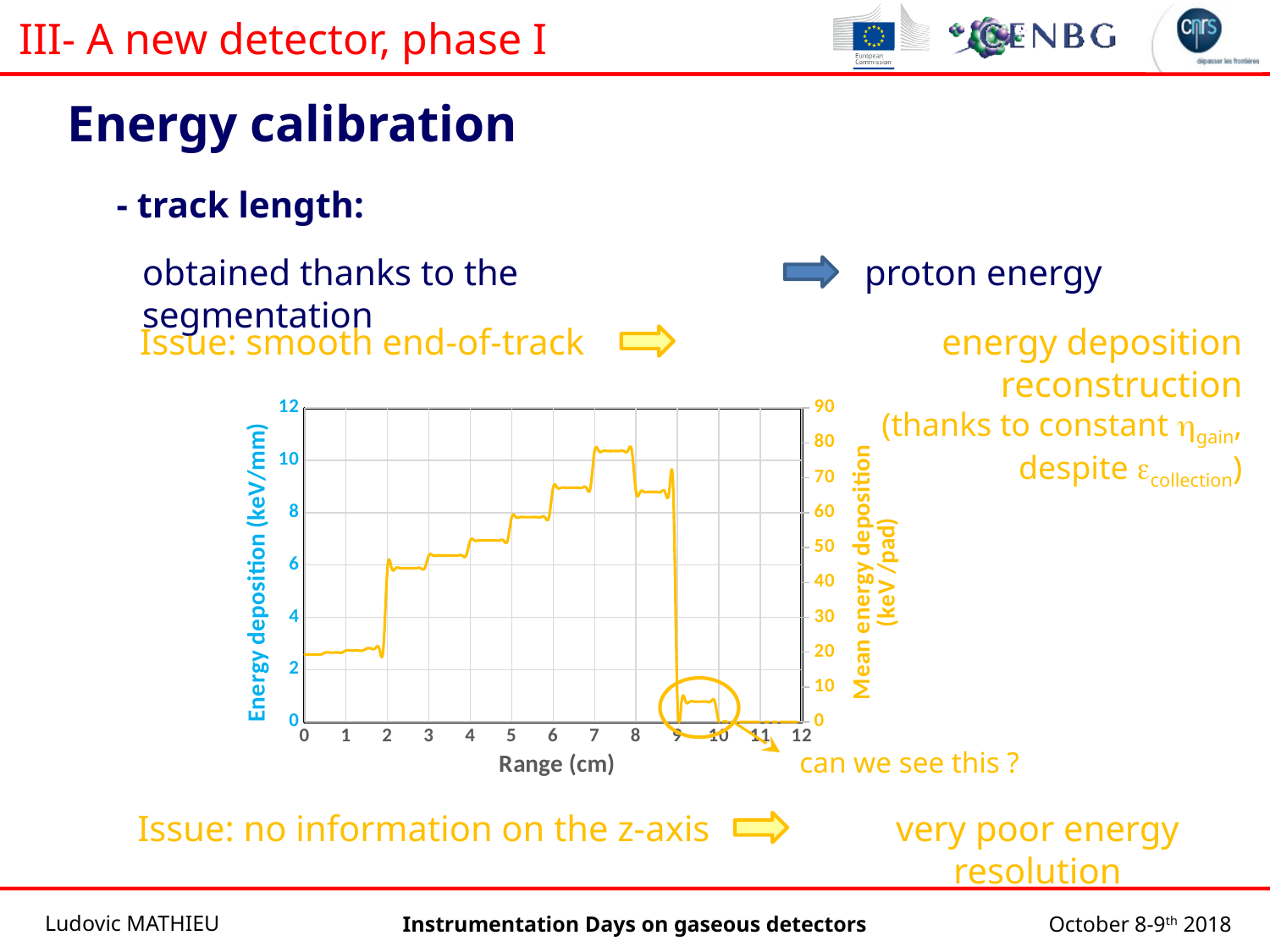
Is the energy deposition at a range of 5 cm greater or less than 6 keV/mm? greater What kind of chart is shown on the slide? line chart What is the highest tick value shown on the right-hand y axis of the chart? 90 What is the title of the left y axis of the chart? Energy deposition (keV/mm) Which is larger, the energy deposition at a range of 2.5 cm or at a range of 6.5 cm? 6.5 cm Is the energy deposition at a range of 3 cm greater or less than 4 keV/mm? greater What is the title of the x axis of the chart? Range (cm) Is the energy deposition at a range of 7.5 cm greater or less than 8 keV/mm? greater Does the energy deposition curve generally rise or fall as the range increases from 0 to 8 cm? rise Which is larger, the energy deposition at a range of 1 cm or at a range of 10 cm? 1 cm